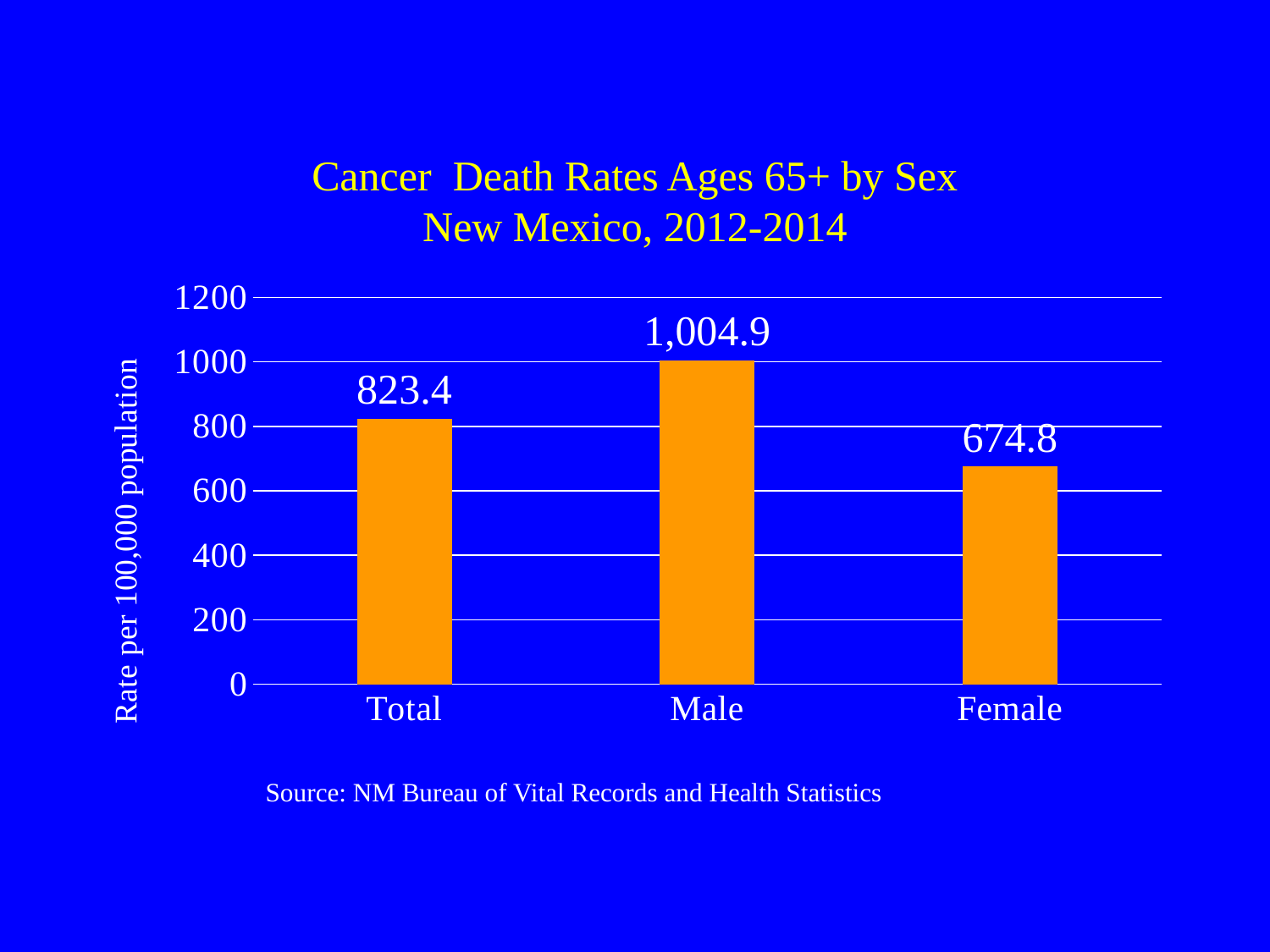
What is the cancer death rate for Female? 674.8 What is the cancer death rate for Male? 1,004.9 How many categories are shown on the x axis? 3 What kind of chart is shown on the slide? bar chart Is the value for Male greater or less than 1000? greater What is the difference between the Total and Female cancer death rates? 148.6 Which category has the highest cancer death rate? Male What is the cancer death rate for Total? 823.4 What is the difference between the Male and Female cancer death rates? 330.1 What is the label of the y axis? Rate per 100,000 population Which is larger, the cancer death rate for Total or for Female? Total Which category has the lowest cancer death rate? Female